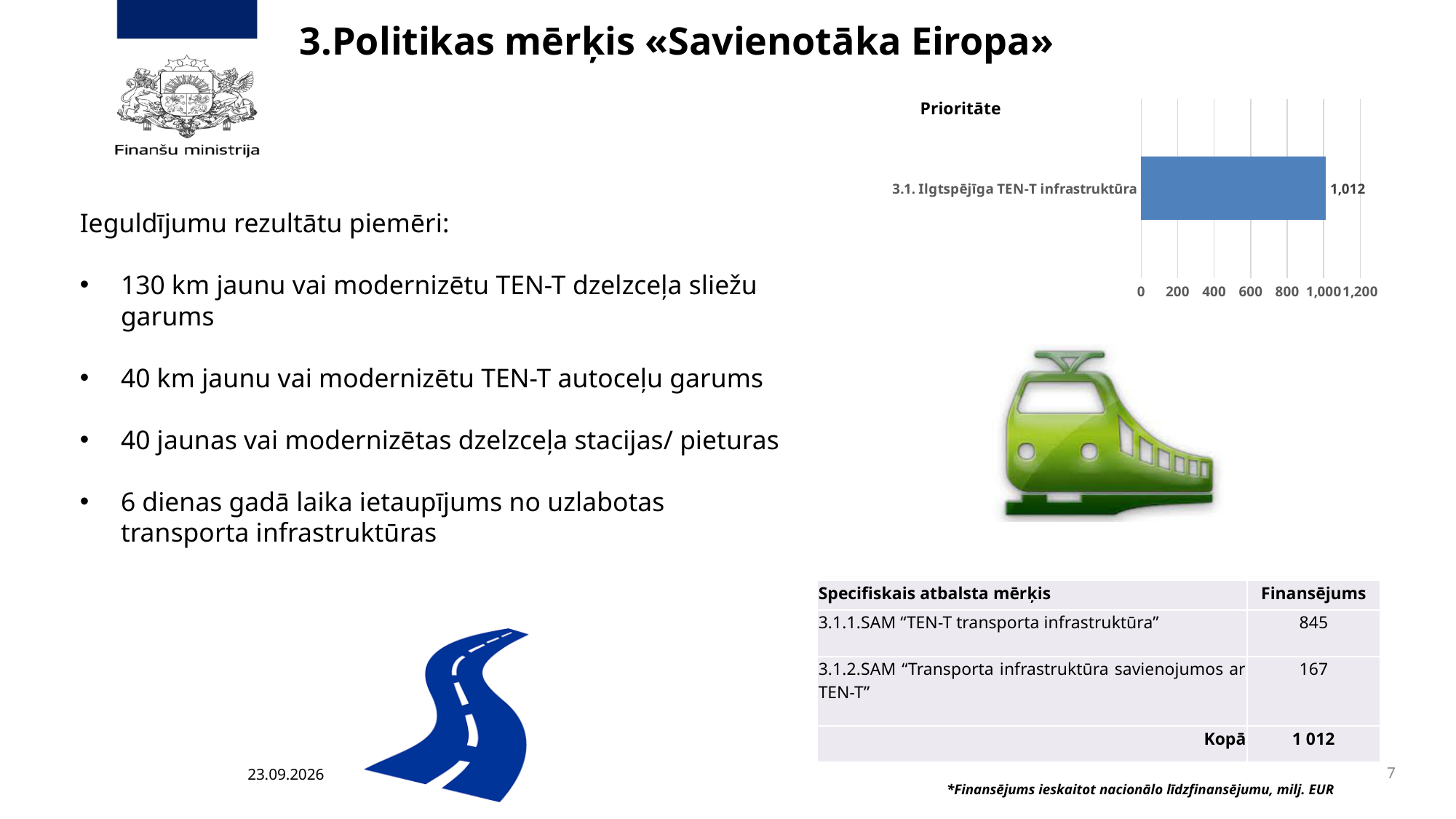
How many categories are plotted in the chart? 1 Is the value for "3.1. Ilgtspējīga TEN-T infrastruktūra" greater or less than 1,000? greater What is the title of the chart? Prioritāte What kind of chart is shown on the slide? bar chart Is the value for "3.1. Ilgtspējīga TEN-T infrastruktūra" greater or less than 1,200? less What is the value shown for "3.1. Ilgtspējīga TEN-T infrastruktūra" in the chart? 1,012 What is the highest tick value shown on the chart's axis? 1,200